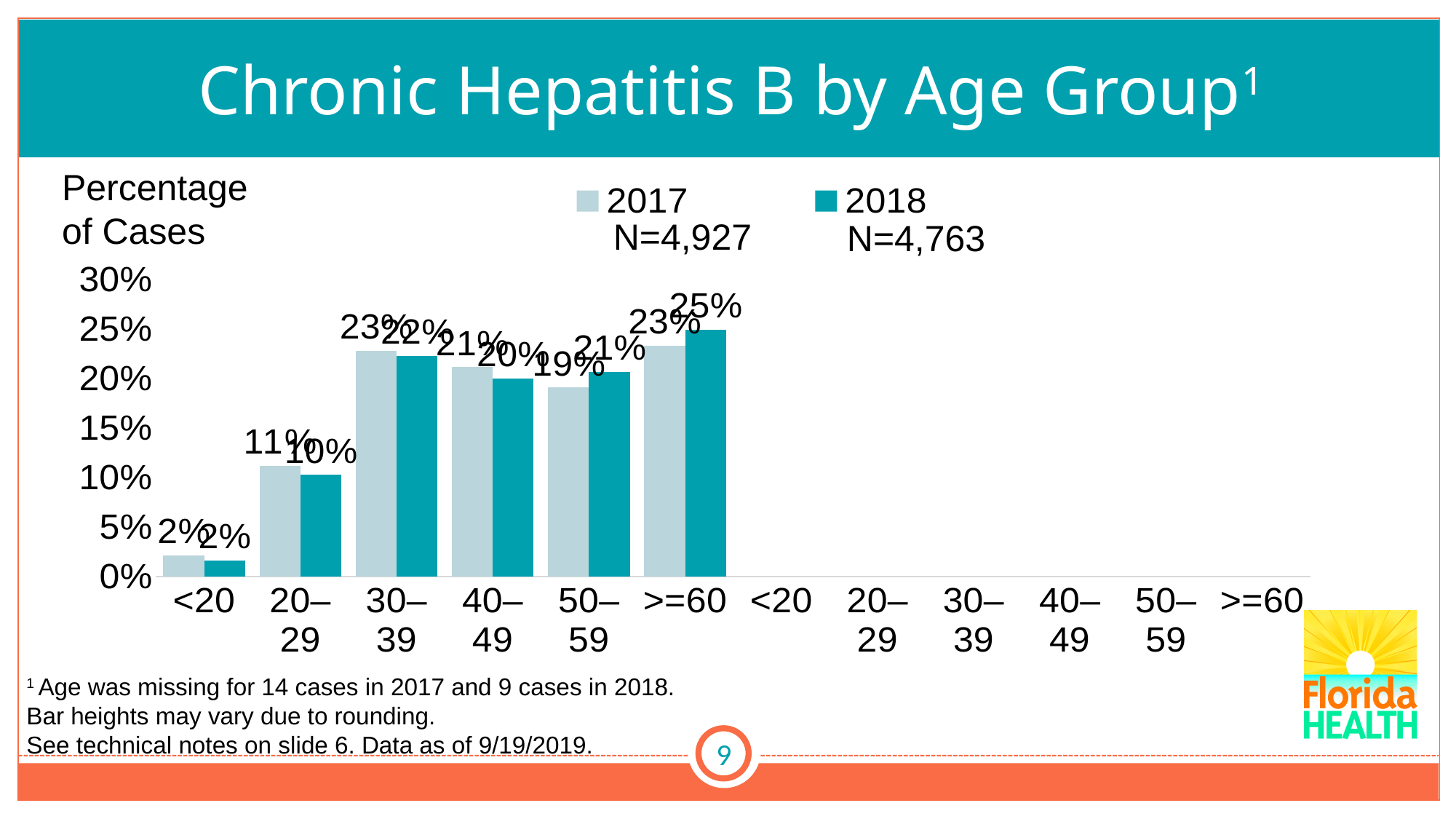
For the 50–59 age group, which year had the larger percentage of cases, 2017 or 2018? 2018 What percentage of cases in 2017 were in the 30–39 age group? 23% How many series does the legend list? 2 What kind of chart is shown on the slide? Bar chart What is the N value shown in the legend for 2017? N=4,927 For the 20–29 age group, which year had the larger percentage of cases, 2017 or 2018? 2017 Which age group had the lowest percentage of cases in 2017? <20 What percentage of cases in 2018 were in the 20–29 age group? 10% Which age group had the highest percentage of cases in 2018? >=60 What percentage of cases in 2017 were in the 50–59 age group? 19% What percentage of cases in 2018 were in the >=60 age group? 25% By how many percentage points did the >=60 age group's share change from 2017 to 2018? 2 percentage points